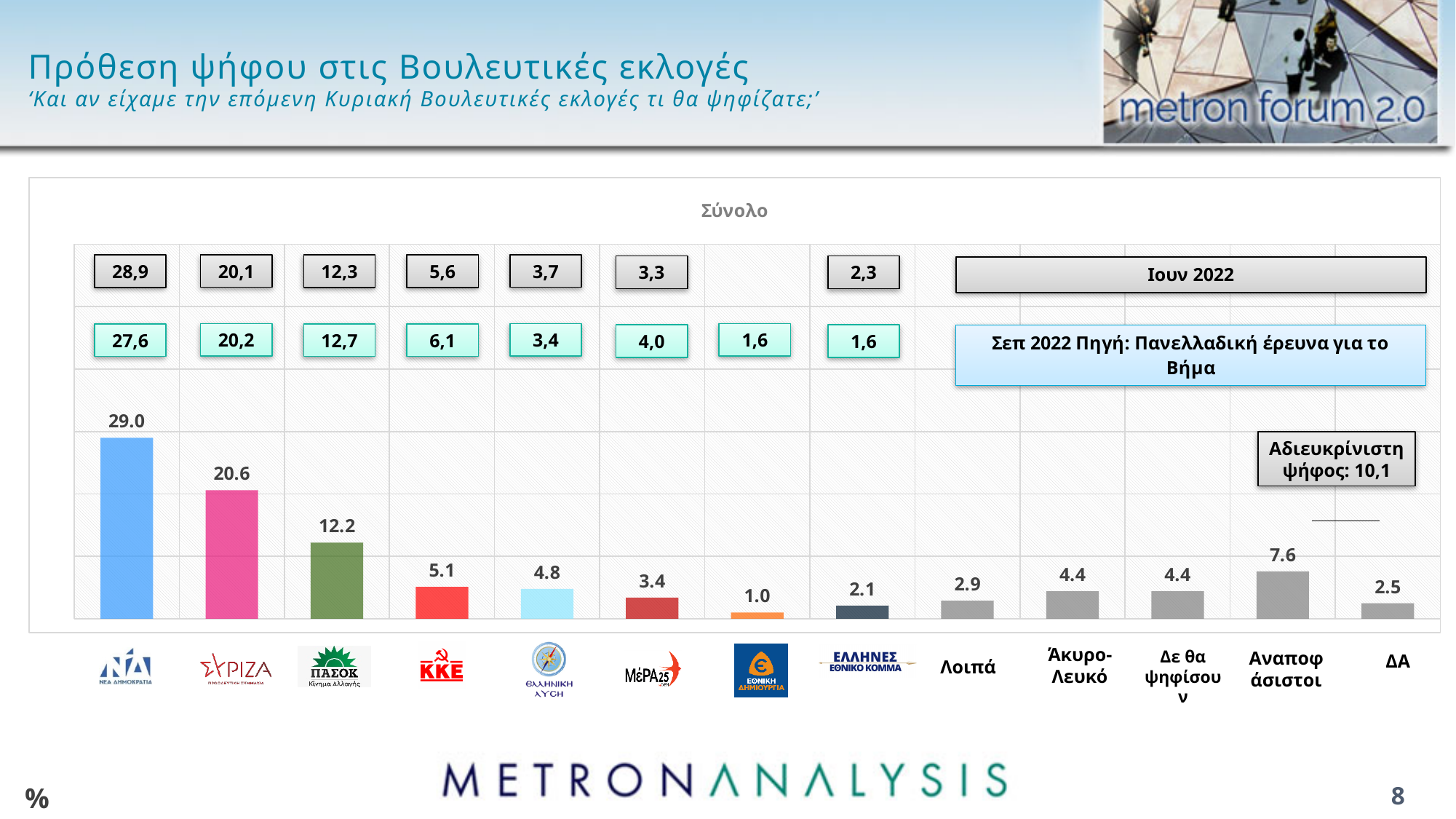
What is the title printed above the chart? Σύνολο Which category has the highest bar in the chart? ΝΕΑ ΔΗΜΟΚΡΑΤΙΑ What is the value of the bar for ΣΥΡΙΖΑ? 20.6 What is the difference between the bar values for ΝΕΑ ΔΗΜΟΚΡΑΤΙΑ and ΣΥΡΙΖΑ? 8.4 What is the difference between the bar values for Αναποφάσιστοι and ΔΑ? 5.1 Which bar is larger, ΚΚΕ or Ελληνική Λύση? ΚΚΕ What is the value of the bar for ΝΕΑ ΔΗΜΟΚΡΑΤΙΑ in the chart? 29.0 How many bars (categories) are plotted in the chart? 13 Which category has the lowest bar in the chart? Εθνική Δημιουργία What kind of chart is shown on the slide? bar chart What value is shown for Αναποφάσιστοι? 7.6 What is the value shown for ΠΑΣΟΚ? 12.2